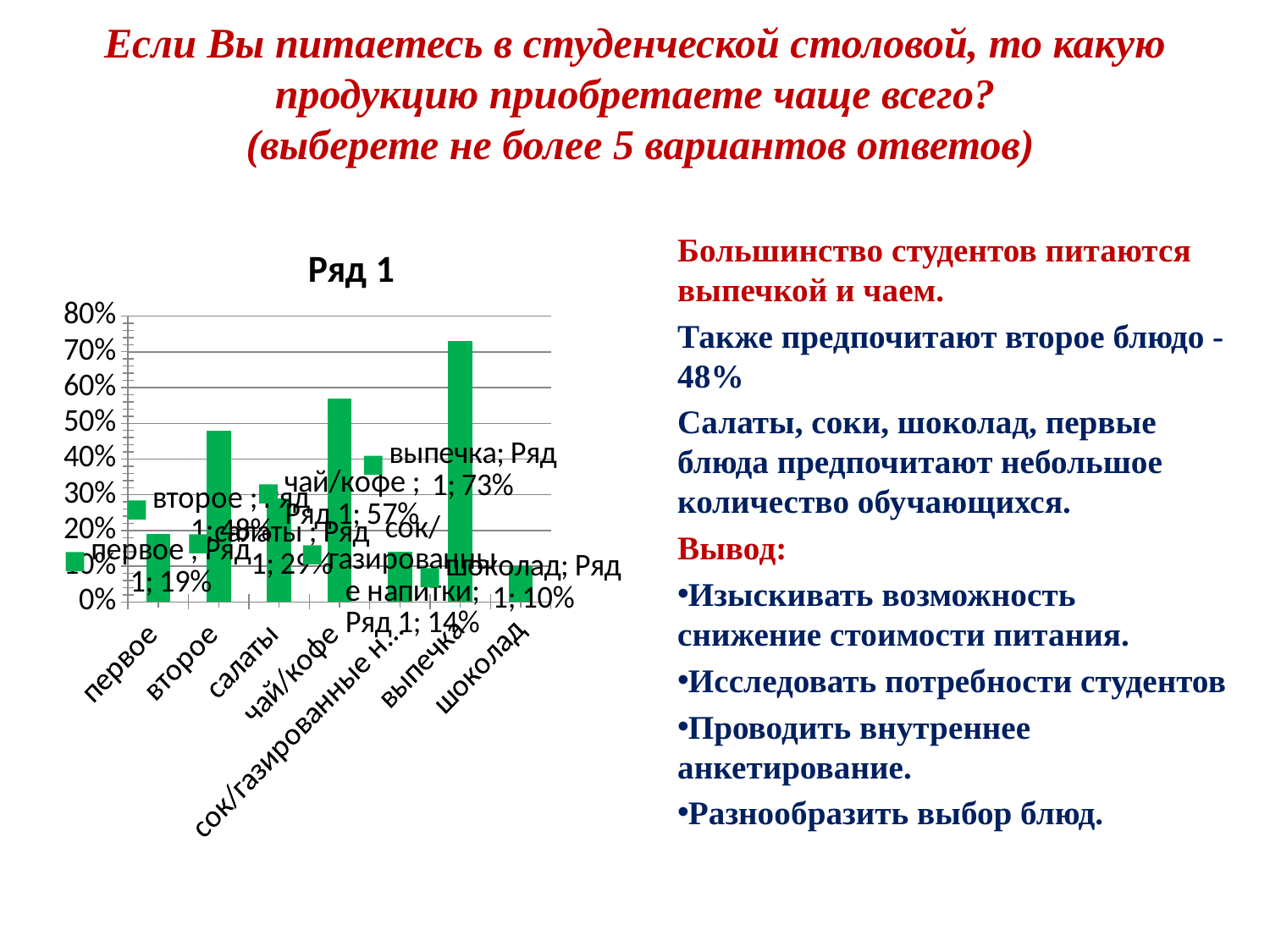
What kind of chart is shown on the slide? bar chart What is the value for первое? 19% Which category has the lowest value? шоколад Which is larger, the value for второе or the value for салаты? второе Is the value for второе greater or less than 40%? greater What is the difference between the values for выпечка and чай/кофе? 16% How many categories are shown on the x axis? 7 What is the value for шоколад? 10% Which category has the highest value? выпечка What is the title of the chart? Ряд 1 What is the value for чай/кофе? 57% What is the value for выпечка? 73%